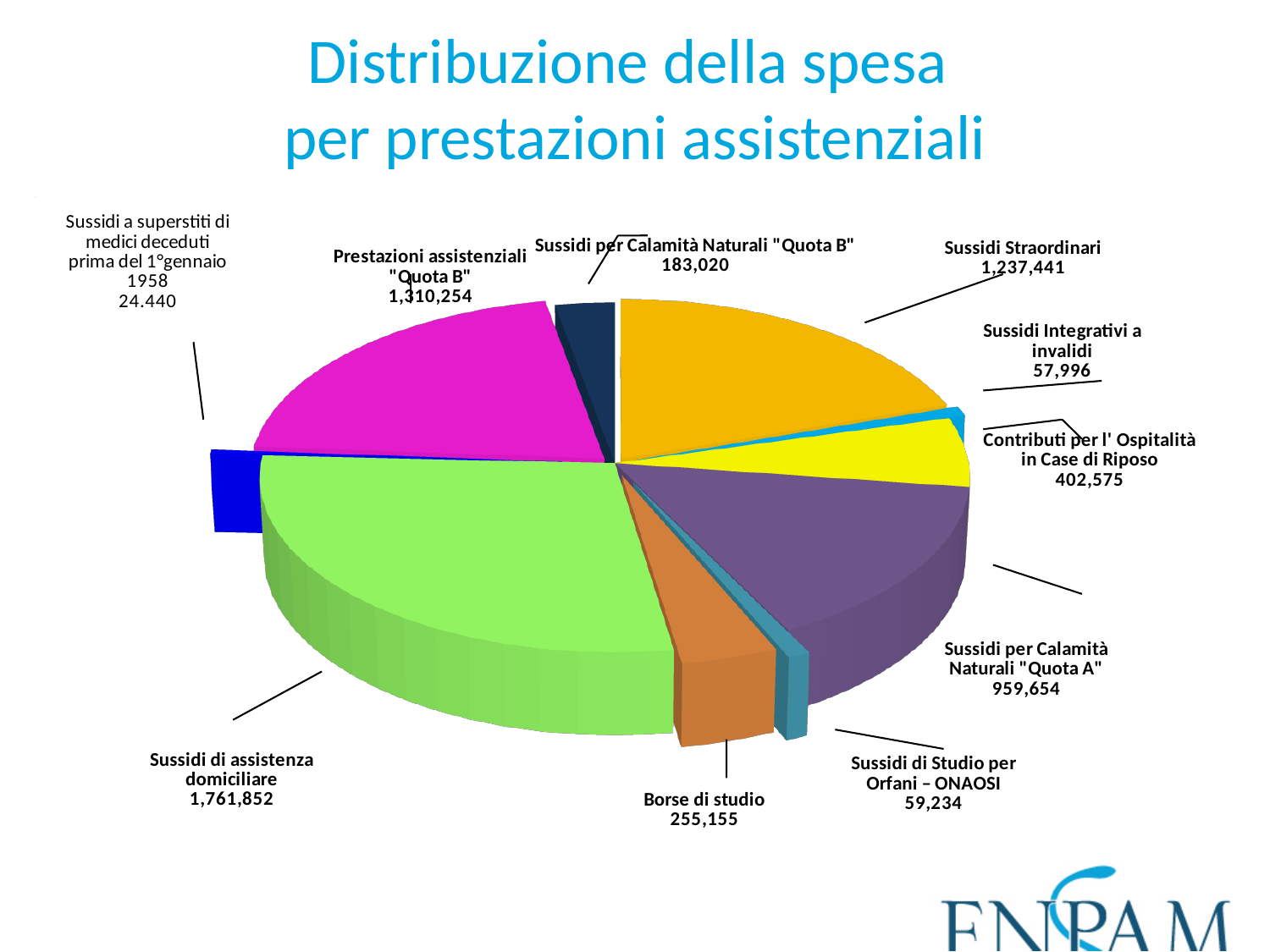
What is the title of the chart? Distribuzione della spesa per prestazioni assistenziali What is the value for Borse di studio? 255,155 Which category has the smallest value in the pie chart? Sussidi a superstiti di medici deceduti prima del 1°gennaio 1958 What is the value for Sussidi Straordinari? 1,237,441 How many categories (slices) does the pie chart have? 10 Which is larger, Borse di studio or Sussidi di Studio per Orfani – ONAOSI? Borse di studio What is the difference between Sussidi di assistenza domiciliare and Prestazioni assistenziali "Quota B"? 451,598 What is the value for Sussidi di assistenza domiciliare? 1,761,852 What is the difference between Sussidi Straordinari and Sussidi per Calamità Naturali "Quota A"? 277,787 What is the value for Contributi per l' Ospitalità in Case di Riposo? 402,575 Which category has the largest value in the pie chart? Sussidi di assistenza domiciliare What type of chart is shown on the slide? Pie chart